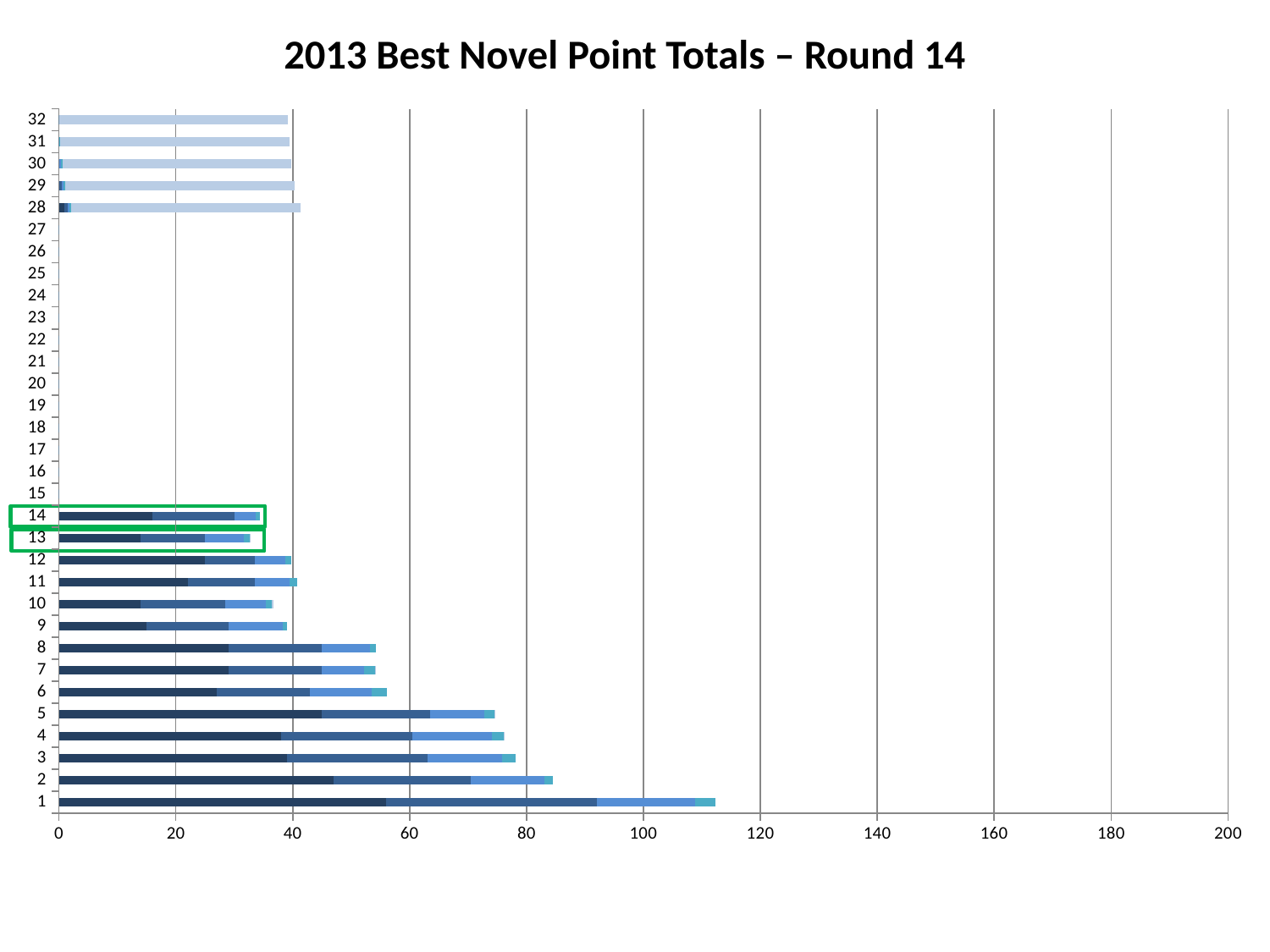
Is the value for category 1 greater or less than 100? greater Is the value for category 2 greater or less than 80? greater What is the title of the chart? 2013 Best Novel Point Totals – Round 14 Is the value for category 5 greater or less than 80? less Which has the larger point total, category 1 or category 2? 1 What kind of chart is shown on the slide? bar chart Which two categories are outlined with green boxes on the chart? 13 and 14 How many categories are listed on the vertical axis of the chart? 32 Which has the larger point total, category 5 or category 8? 5 Which category has the highest point total? 1